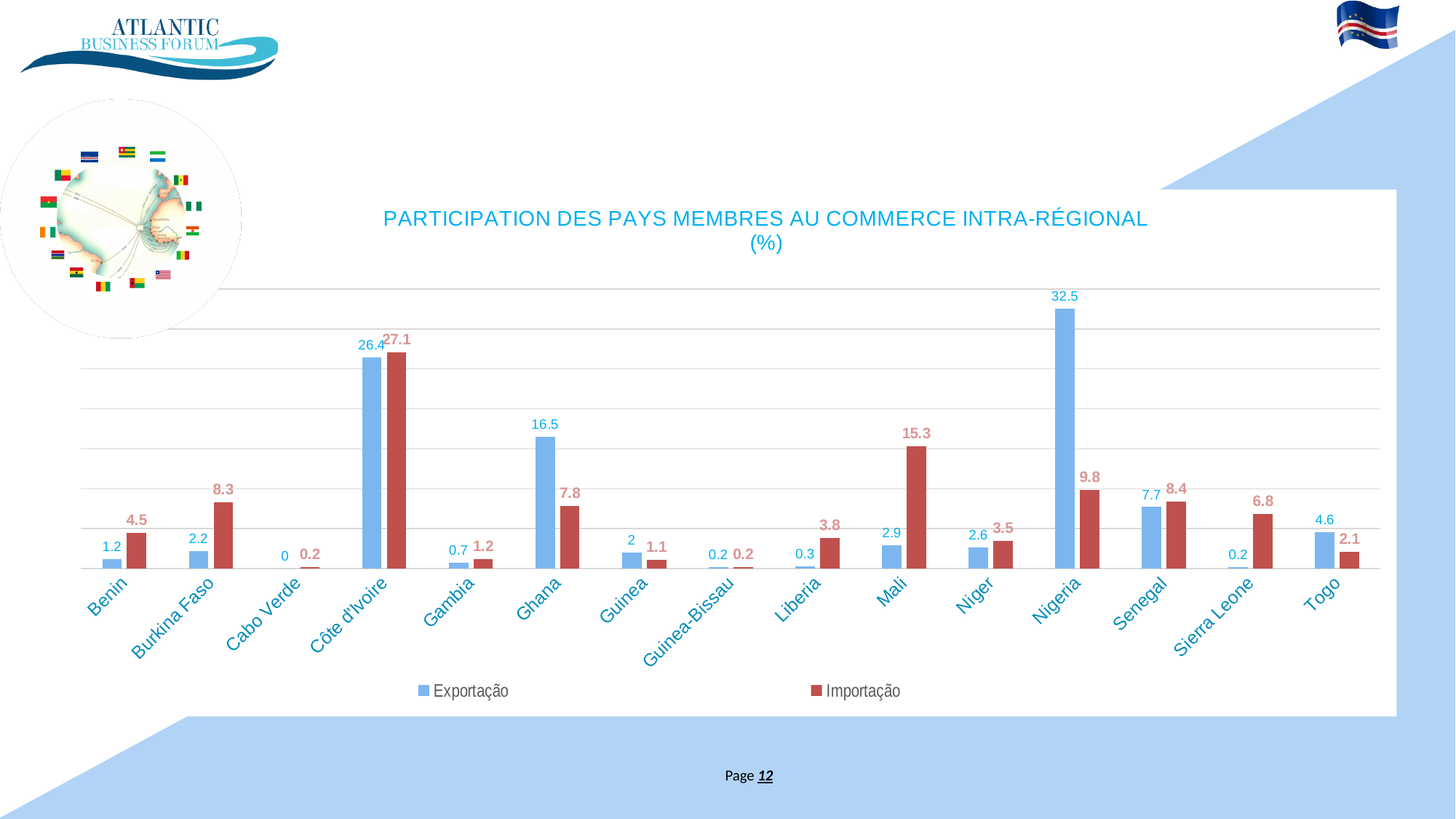
What is the Exportação value for Côte d'Ivoire? 26.4 Which is larger for Ghana, the Exportação value or the Importação value? Exportação What is the Importação value for Sierra Leone? 6.8 What is the difference between the Importação and Exportação values for Mali? 12.4 What kind of chart is shown on the slide? Bar chart How many countries are shown on the x axis? 15 Which country has the highest Exportação value? Nigeria What is the Exportação value for Nigeria? 32.5 Which country has the highest Importação value? Côte d'Ivoire How many series does the legend list? 2 Which country has the lowest Exportação value? Cabo Verde What is the Importação value for Mali? 15.3